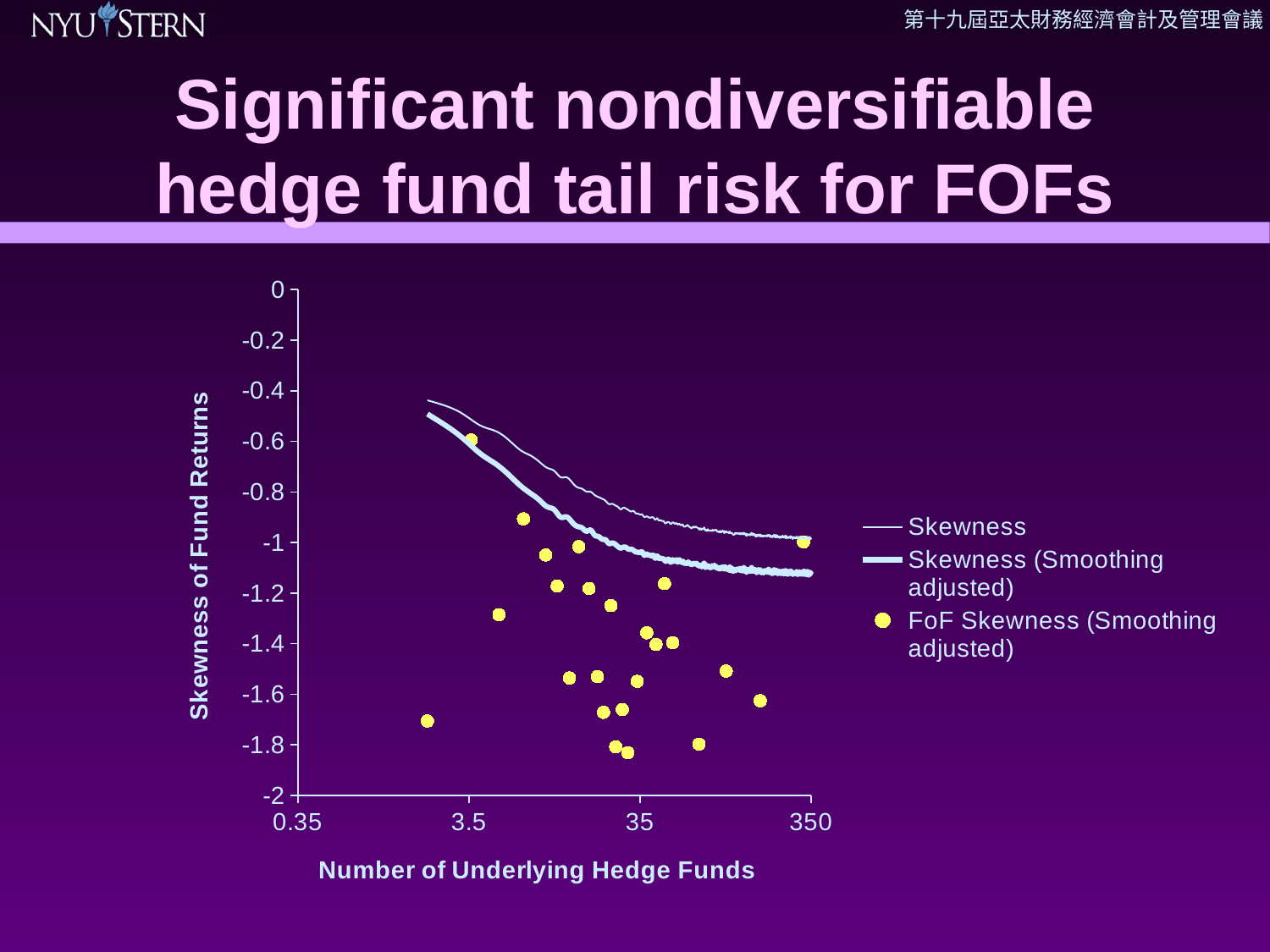
What is the title of the y axis? Skewness of Fund Returns What is the lowest value labelled on the y axis? -2 Is the Skewness (Smoothing adjusted) line at 3.5 underlying hedge funds greater or less than -0.8? greater Which series is plotted as yellow points rather than a line? FoF Skewness (Smoothing adjusted) Is the Skewness line at 3.5 underlying hedge funds greater or less than -0.6? greater Is the Skewness (Smoothing adjusted) line at 350 underlying hedge funds greater or less than -0.8? less Does the Skewness (Smoothing adjusted) line rise or fall along the x axis? fall At 350 underlying hedge funds, which line is higher: Skewness or Skewness (Smoothing adjusted)? Skewness Does the Skewness line rise or fall as the number of underlying hedge funds increases? fall How many tick labels are shown on the x axis? 4 What is the title of the x axis? Number of Underlying Hedge Funds How many series does the legend list? 3